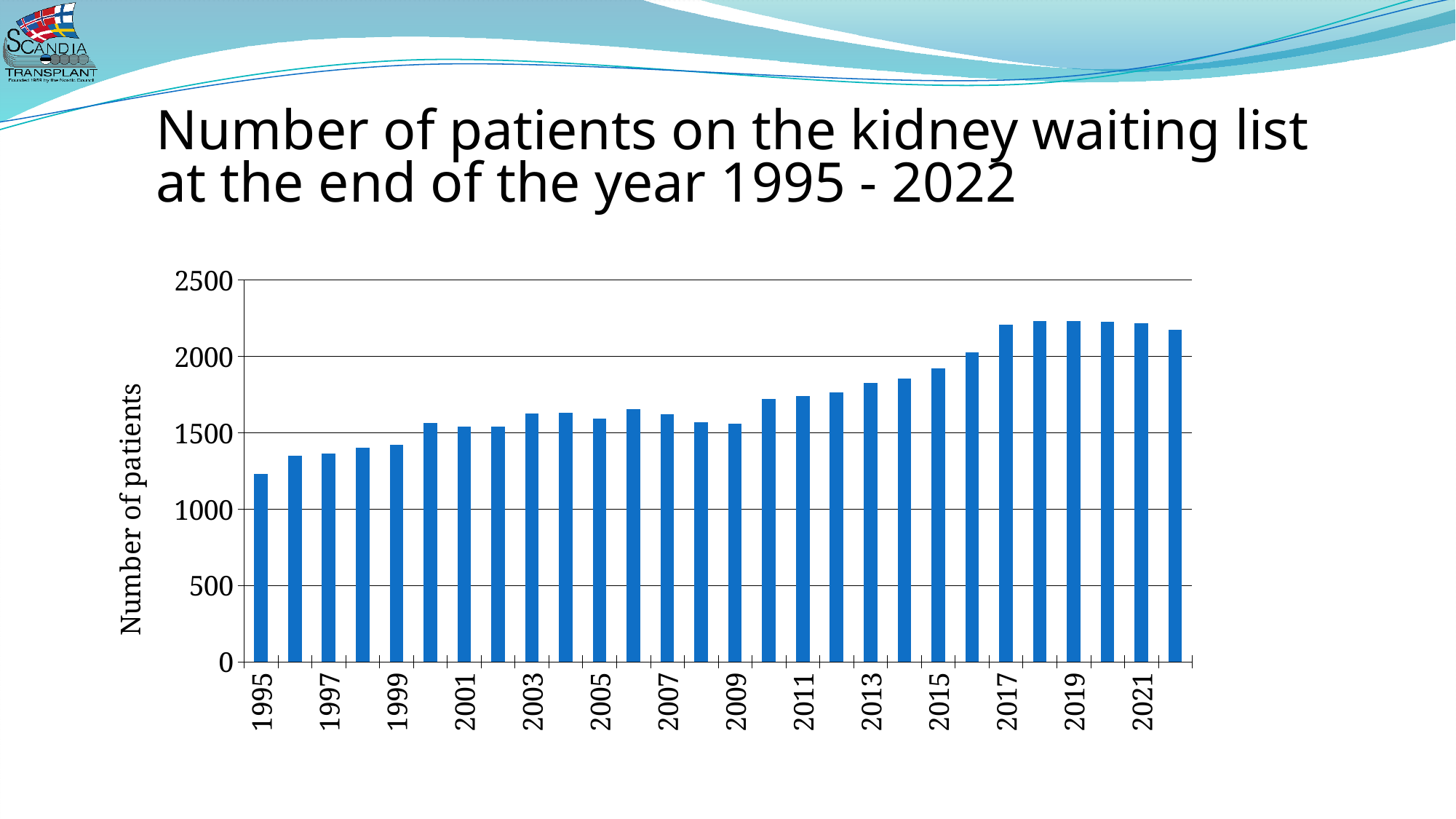
Which year has the larger value, 2017 or 1995? 2017 How many years (bars) are plotted in the chart? 28 What is the label on the vertical axis of the chart? Number of patients What kind of chart is shown on the slide? bar chart Is the value for 2013 greater or less than 2000? less Is the value for 1995 greater or less than 1500? less Do the values generally rise or fall from 1995 to 2022? rise Is the value for 2017 greater or less than 2000? greater Which year has the larger value, 2013 or 2003? 2013 Which year has the lowest number of patients on the kidney waiting list? 1995